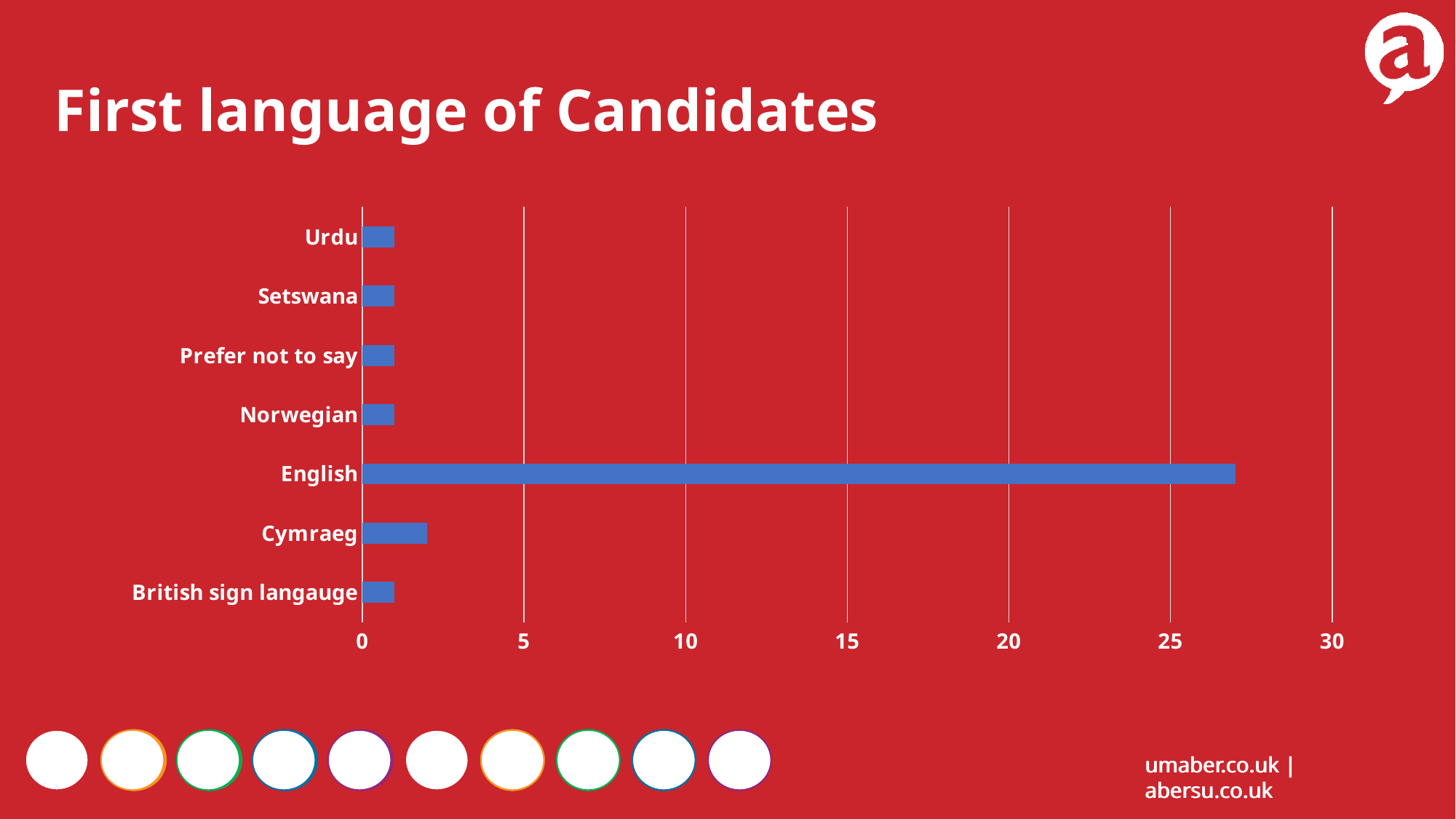
Is the value for Cymraeg greater or less than 5? less What is the highest value shown on the horizontal axis? 30 Which category has the highest value? English How many language categories are shown on the chart? 7 Which is larger, the value for Cymraeg or the value for Setswana? Cymraeg Is the value for English greater or less than 25? greater Is the value for Norwegian greater or less than 10? less Which is larger, the value for English or the value for Cymraeg? English What kind of chart is shown on the slide? bar chart What is the title of the chart? First language of Candidates